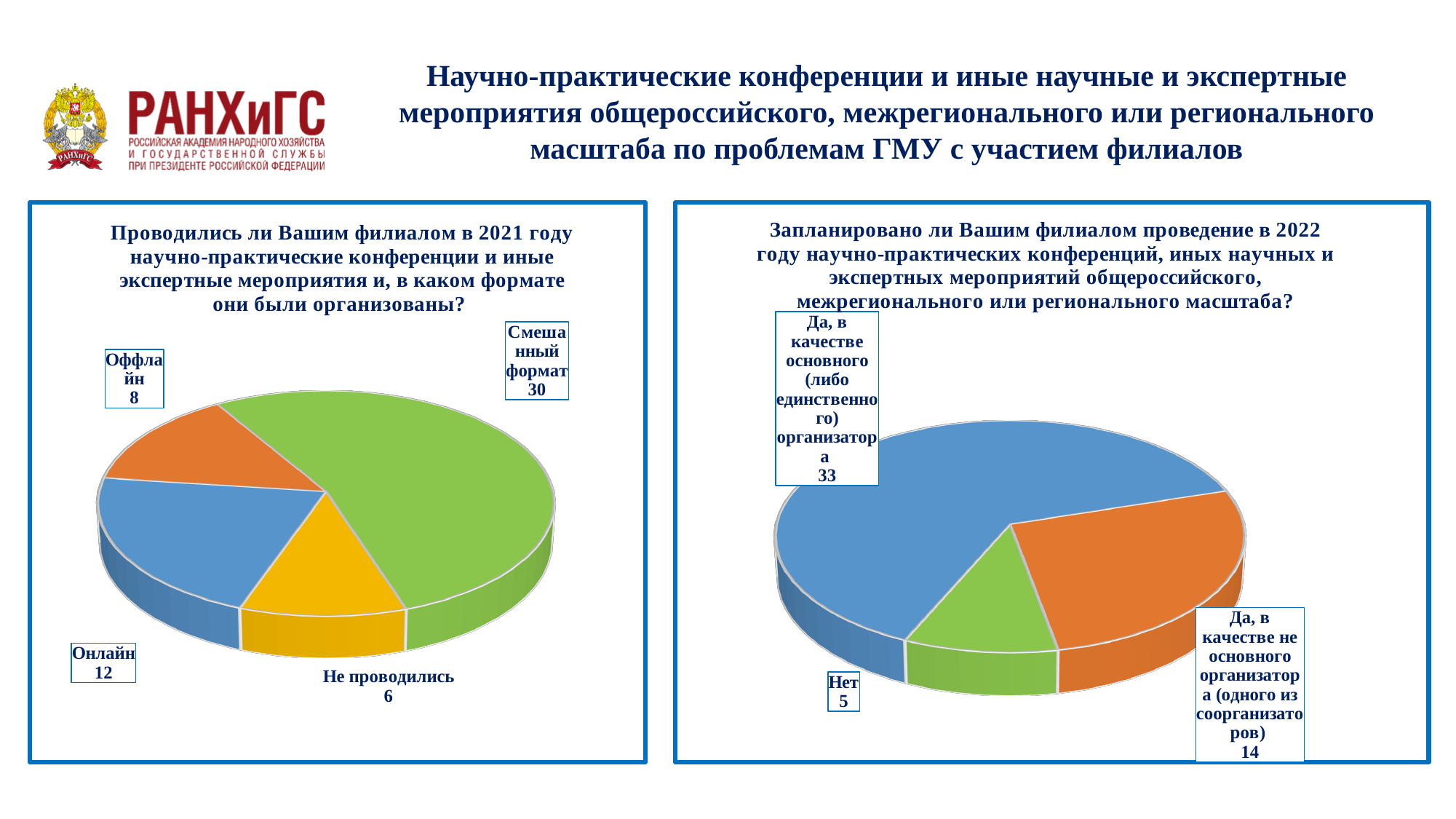
In the left pie chart, what is the difference between «Онлайн» and «Оффлайн»? 4 What type of chart is used on the right side of the slide? Pie chart In the left pie chart, which category has the smallest value? Не проводились In the left pie chart, what is the value for «Смешанный формат»? 30 In the left pie chart, which category has the largest value? Смешанный формат In the left pie chart, what is the total of all slices? 56 In the left pie chart, how many categories are shown? 4 In the right pie chart, what is the value for «Нет»? 5 In the left pie chart, what is the value for «Онлайн»? 12 In the right pie chart, what is the value for «Да, в качестве не основного организатора (одного из соорганизаторов)»? 14 In the right pie chart, which category has the largest value? Да, в качестве основного (либо единственного) организатора In the right pie chart, what is the difference between the two «Да» categories? 19